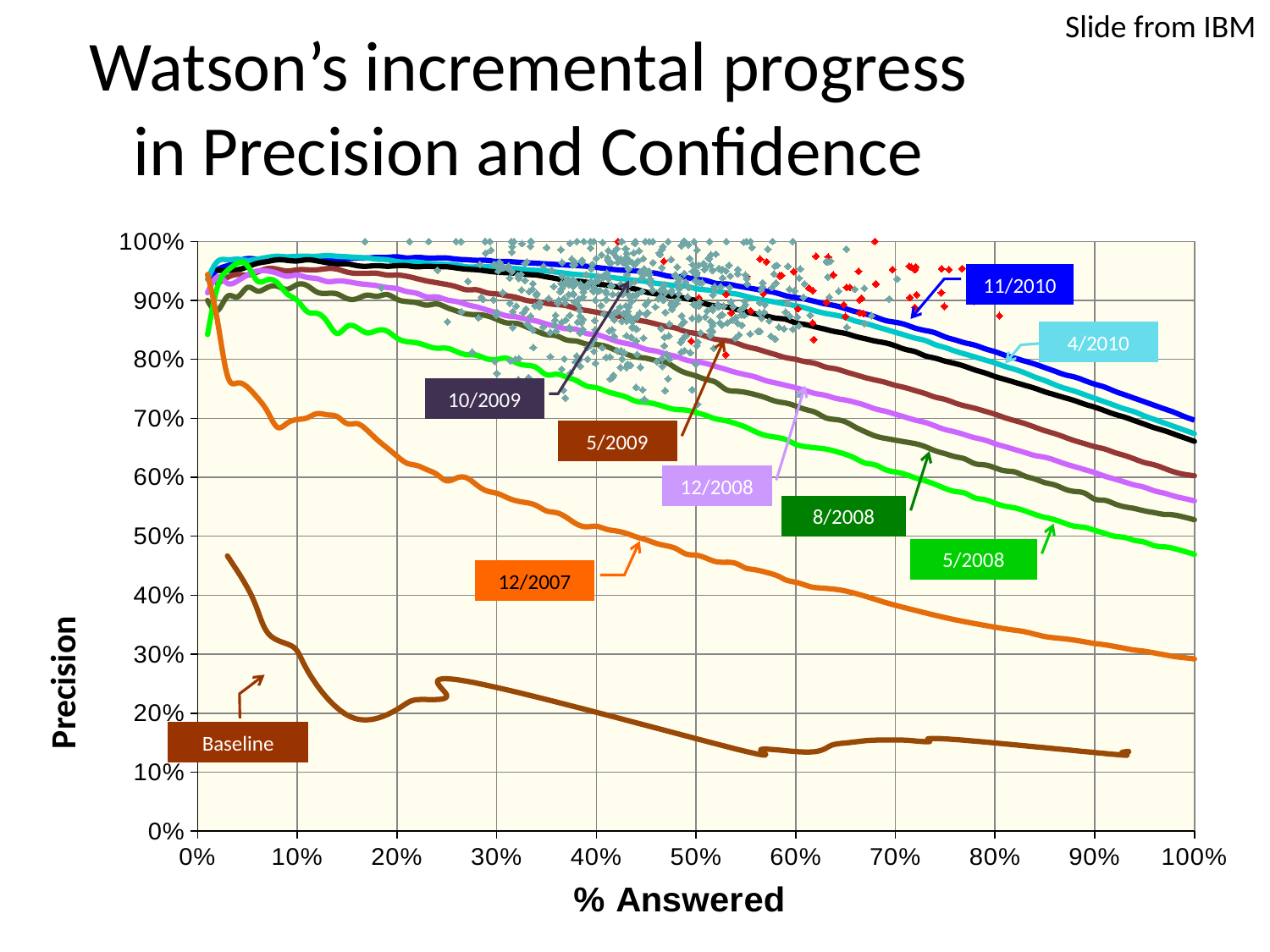
What kind of chart is shown on the slide? line chart What is the label of the y axis of the chart? Precision Which labeled series has the lowest precision across the chart? Baseline Does precision for the 12/2007 series rise or fall as % Answered increases? fall At 100% answered, which series has higher precision, 11/2010 or 5/2008? 11/2010 Is the precision of the 11/2010 series at 100% answered greater or less than 60%? greater Is the precision of the Baseline series at 90% answered greater or less than 20%? less What is the label of the x axis of the chart? % Answered How many labeled series (callout boxes) are shown on the chart? 9 Is the precision of the 12/2007 series at 100% answered greater or less than 40%? less Which labeled series has the highest precision at 100% answered? 11/2010 At 50% answered, which series has higher precision, Baseline or 12/2007? 12/2007